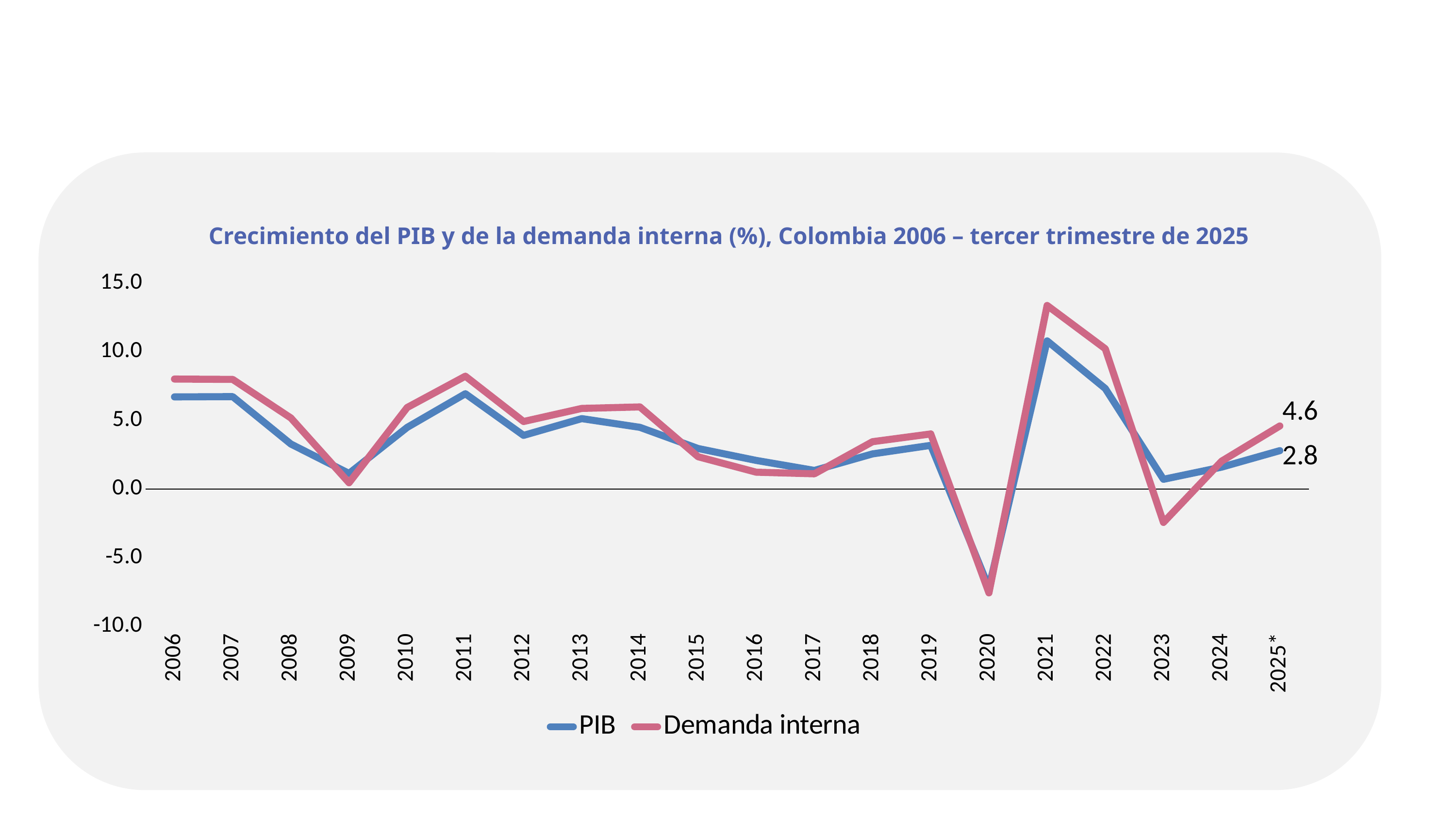
What is the difference between the Demanda interna and PIB values for 2025*? 1.8 Is the Demanda interna value for 2023 greater or less than 0.0? less In which year does Demanda interna reach its lowest value? 2020 In 2025*, which series has the larger value, PIB or Demanda interna? Demanda interna What is the Demanda interna value for 2025*? 4.6 What kind of chart is shown on the slide? Line chart What is the PIB value for 2025*? 2.8 Is the PIB value for 2021 greater or less than 10.0? greater In which year does Demanda interna reach its highest value? 2021 How many years are shown on the x axis? 20 How many series does the legend list? 2 Does the PIB line rise or fall from 2021 to 2023? Fall